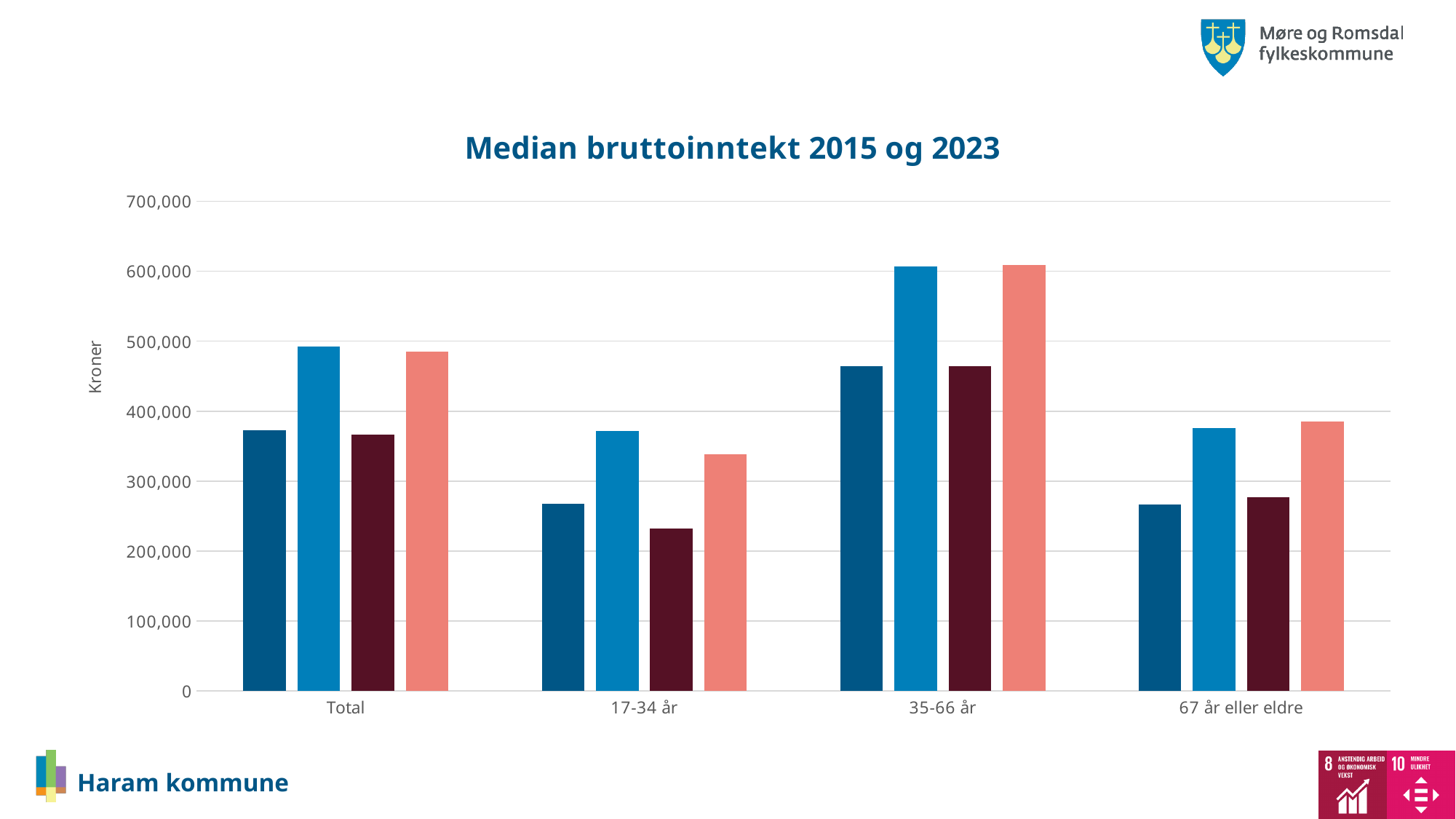
Is the value of the salmon-coloured bar for 17-34 år greater or less than 400,000? less What label is shown on the vertical axis of the chart? Kroner How many categories are shown along the x axis of the chart? 4 What kind of chart is shown on the slide? bar chart Which category has the shortest dark red bar? 17-34 år How many bars are plotted for each category in the chart? 4 Which category has the tallest light blue bar? 35-66 år Is the value of the dark blue bar for Total greater or less than 300,000? greater Is the value of the light blue bar for 35-66 år greater or less than 500,000? greater What is the title of the chart? Median bruttoinntekt 2015 og 2023